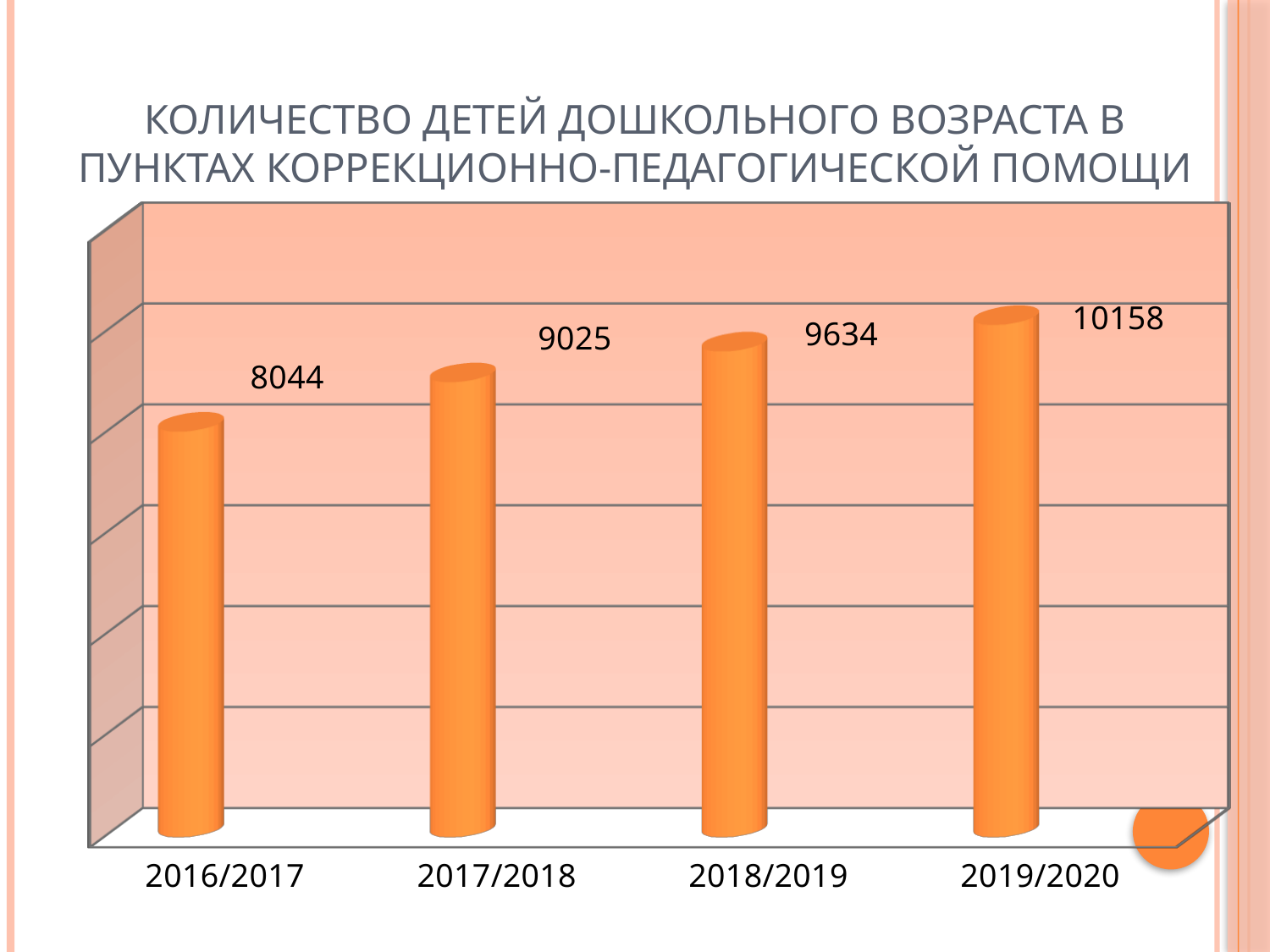
Do the values rise or fall from 2016/2017 to 2019/2020? rise What is the difference between the values for 2018/2019 and 2017/2018? 609 What is the value for 2017/2018? 9025 Which year has the lowest value? 2016/2017 What kind of chart is this? bar chart How many categories are shown on the x axis? 4 What is the value for 2019/2020? 10158 What is the value for 2016/2017? 8044 What is the value for 2018/2019? 9634 What is the difference between the values for 2019/2020 and 2016/2017? 2114 Which year has the highest value? 2019/2020 Which is larger, the value for 2017/2018 or the value for 2018/2019? 2018/2019